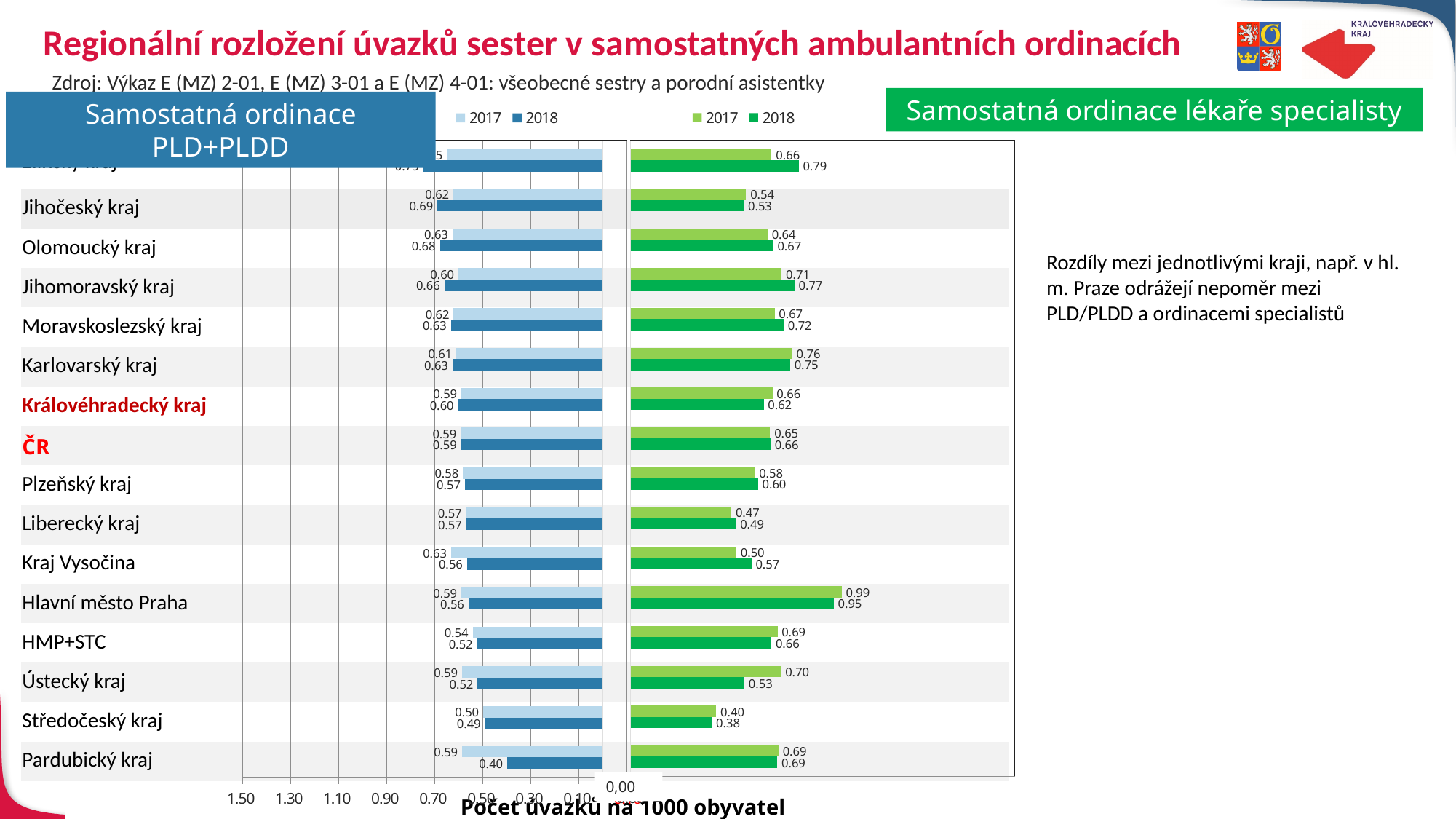
In the Samostatná ordinace lékaře specialisty chart, which region has the lowest 2017 value? Středočeský kraj In the Samostatná ordinace PLD+PLDD chart, what is the 2017 value for Královéhradecký kraj? 0.59 In the Samostatná ordinace PLD+PLDD chart, what is the 2018 value for Pardubický kraj? 0.40 In the Samostatná ordinace lékaře specialisty chart, what is the difference between the 2017 and 2018 values for Ústecký kraj? 0.17 What kind of chart is the Samostatná ordinace lékaře specialisty chart? Bar chart How many series does the legend of the Samostatná ordinace PLD+PLDD chart list? 2 In the Samostatná ordinace lékaře specialisty chart, what is the 2018 value for Hlavní město Praha? 0.95 In the Samostatná ordinace lékaře specialisty chart, which region has the highest 2018 value? Hlavní město Praha In the Samostatná ordinace lékaře specialisty chart, which is larger for Kraj Vysočina: the 2017 value or the 2018 value? 2018 In the Samostatná ordinace lékaře specialisty chart, what is the 2017 value for Ústecký kraj? 0.70 In the Samostatná ordinace PLD+PLDD chart, what is the difference between the 2017 and 2018 values for Pardubický kraj? 0.19 In the Samostatná ordinace PLD+PLDD chart, which region has the lowest 2018 value? Pardubický kraj